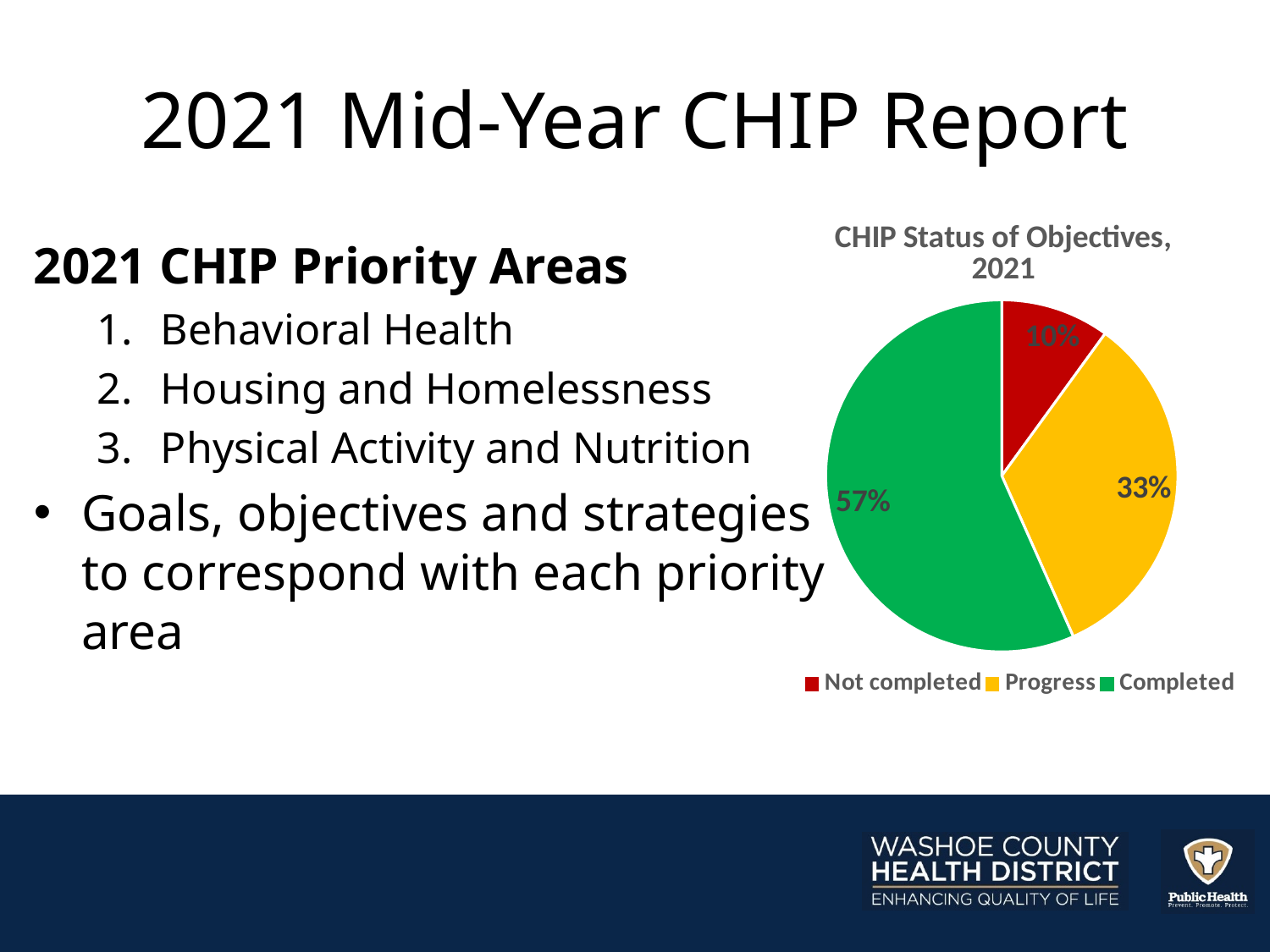
Which colour represents the Completed category in the legend? green What is the difference in percentage points between the Progress share and the Not completed share? 23 What share of objectives is Not completed? 10% What kind of chart is shown on the slide? pie chart Which status category has the largest share of the pie? Completed Which is larger, the share for Progress or the share for Not completed? Progress What is the difference in percentage points between the Completed share and the Progress share? 24 How many categories does the pie chart show? 3 What share of objectives is Completed? 57% Which status category has the smallest share of the pie? Not completed What share of objectives is in Progress? 33% What is the title of the chart? CHIP Status of Objectives, 2021